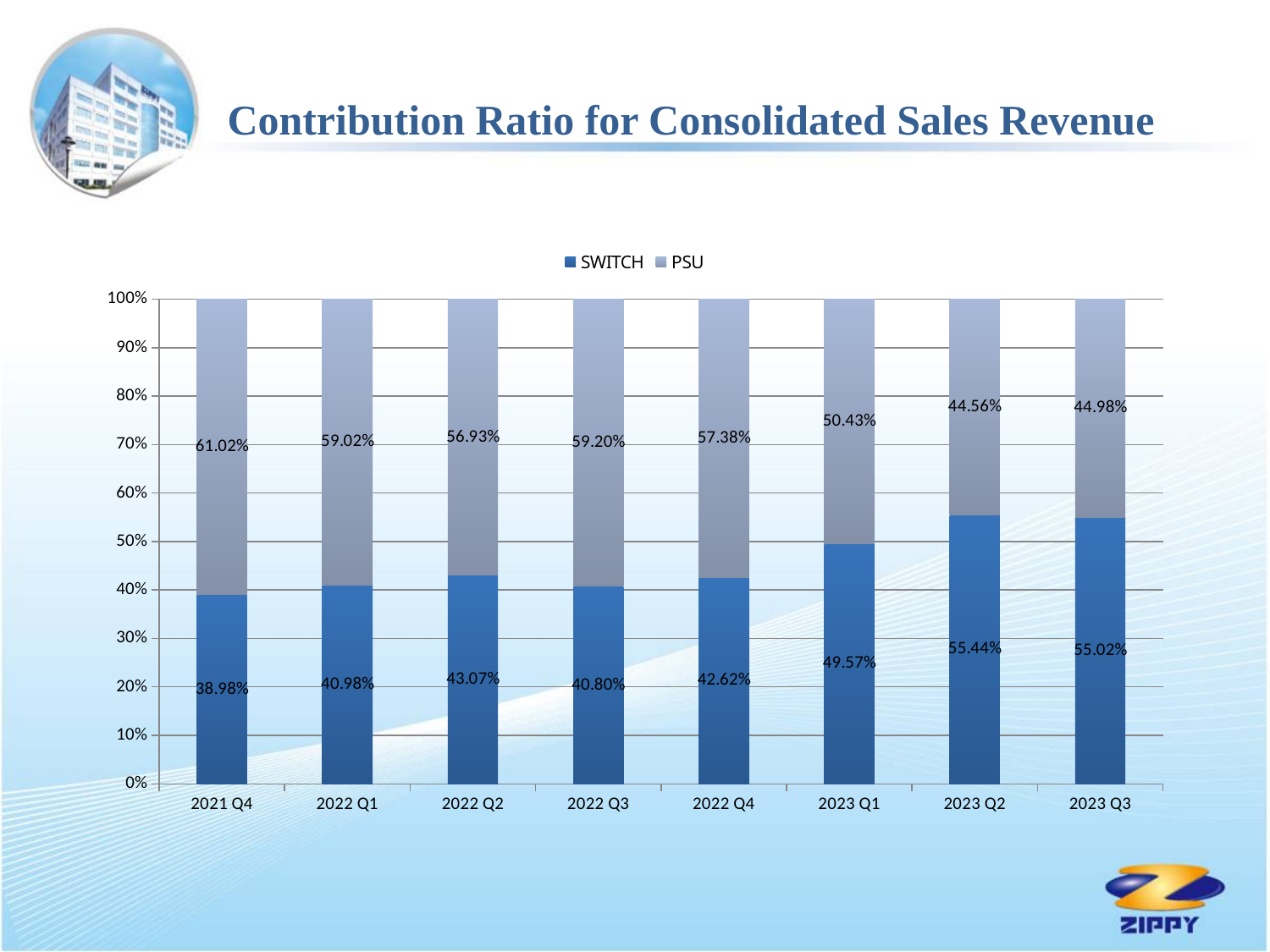
In which quarter is the PSU contribution ratio lowest? 2023 Q2 How many series does the legend list? 2 In which quarter is the PSU contribution ratio highest? 2021 Q4 What kind of chart is shown on the slide? Stacked bar chart What is the SWITCH contribution ratio for 2021 Q4? 38.98% How many quarters are shown on the x axis? 8 What is the SWITCH contribution ratio for 2022 Q2? 43.07% Which is larger in 2023 Q3, the SWITCH ratio or the PSU ratio? SWITCH In which quarter is the SWITCH contribution ratio highest? 2023 Q2 What is the difference between the PSU and SWITCH contribution ratios in 2021 Q4? 22.04% What is the title of the chart on the slide? Contribution Ratio for Consolidated Sales Revenue What is the PSU contribution ratio for 2023 Q1? 50.43%